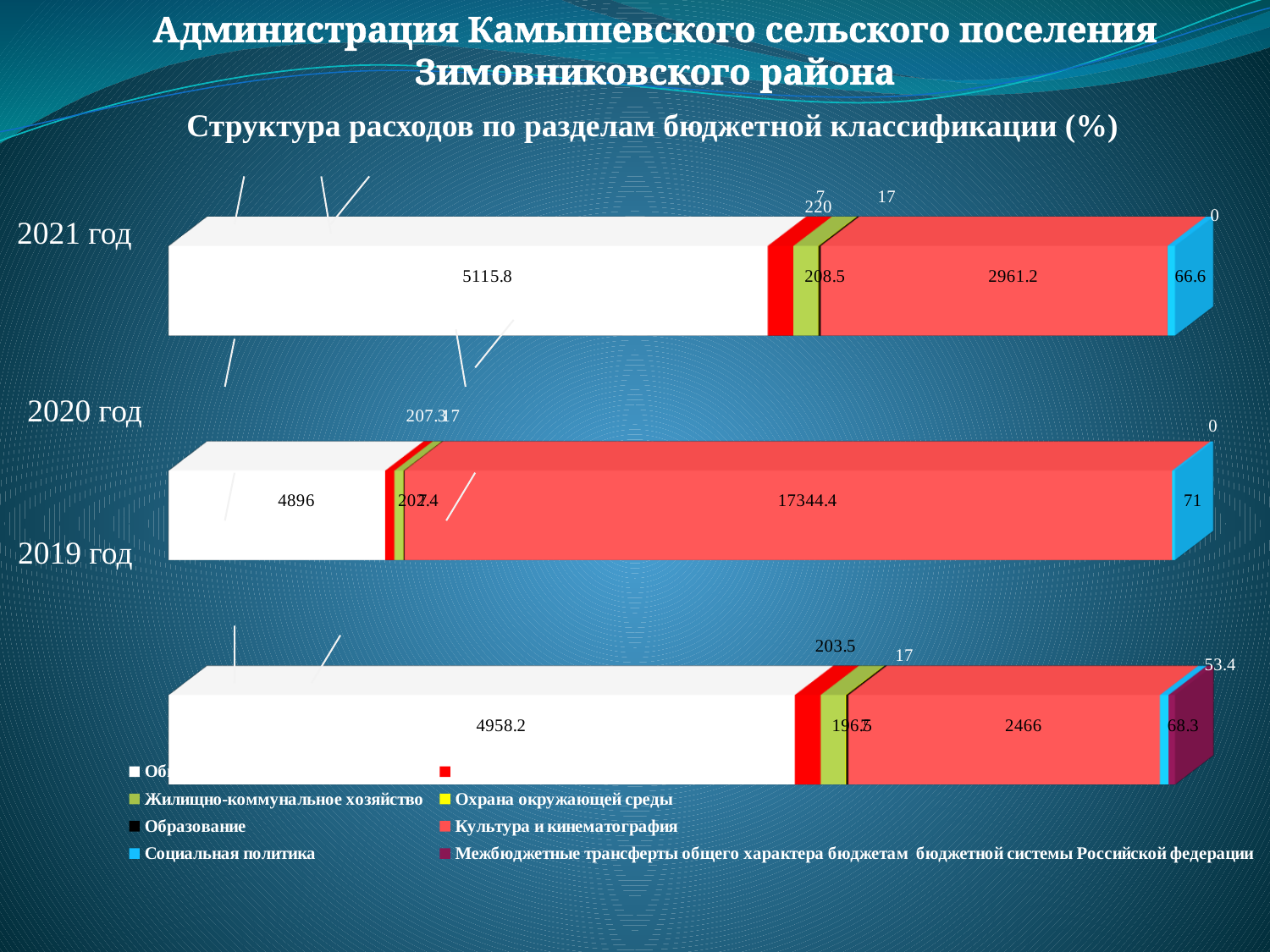
What kind of chart is shown on the slide? Stacked bar chart What is the value of the first (white) segment of the 2021 год bar? 5115.8 How many year bars are shown in the chart? 3 What is the value of the first (white) segment of the 2020 год bar? 4896 What is the value of the Культура и кинематография segment for 2020 год? 17344.4 What is the value of the Культура и кинематография segment for 2019 год? 2466 What is the value of the Социальная политика segment for 2021 год? 66.6 What is the value of the Межбюджетные трансферты segment (purple) in the 2019 год bar? 53.4 Which year has the highest value for Культура и кинематография? 2020 год What is the difference between the white segment values for 2021 год (5115.8) and 2019 год (4958.2)? 157.6 Which is larger: the Социальная политика value for 2020 год or for 2019 год? 2020 год What is the value of the Охрана окружающей среды segment in the 2019 год bar? 7